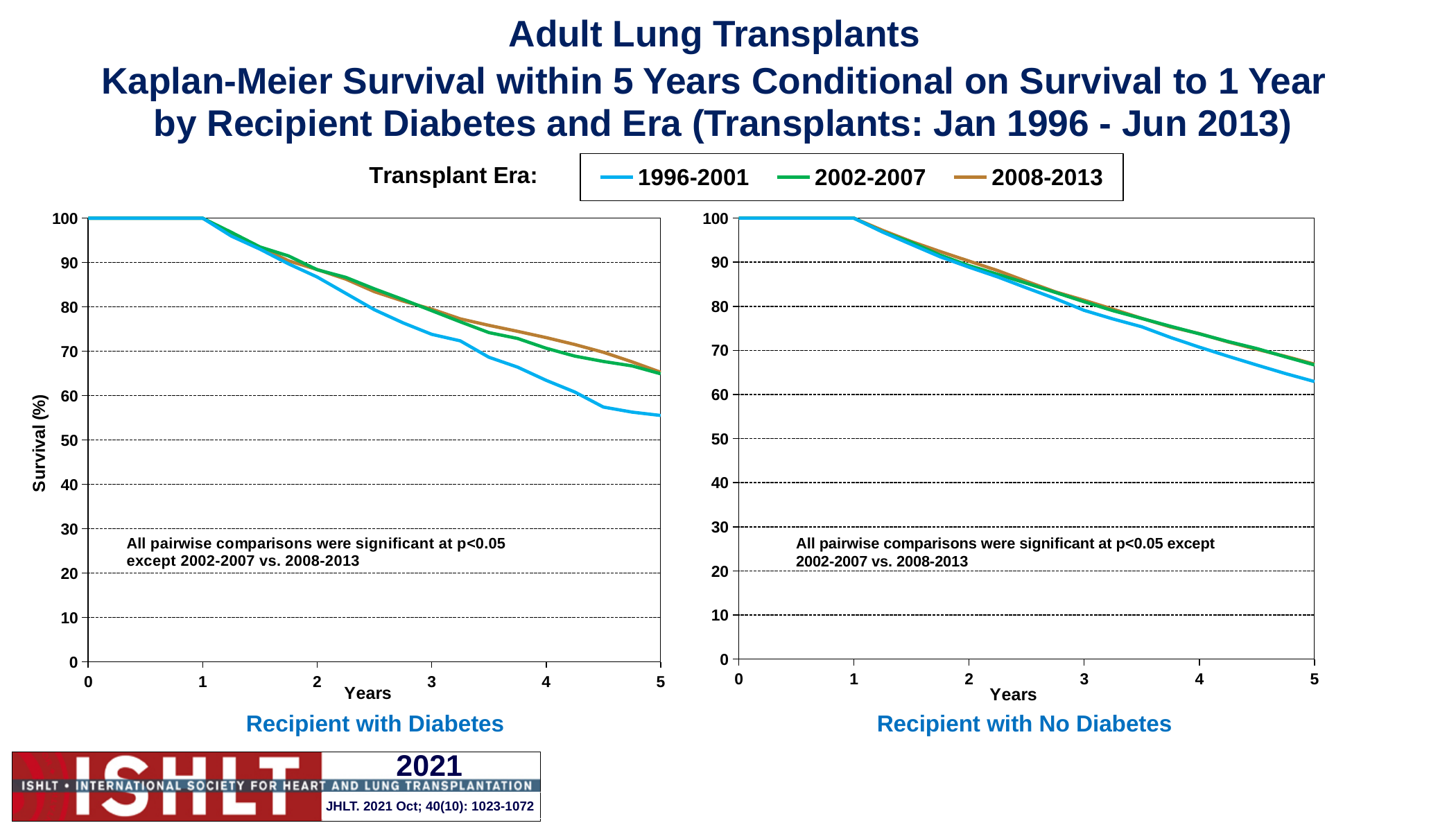
How many transplant eras does the legend list? 3 In the 'Recipient with Diabetes' chart, is the survival for 1996-2001 at year 3 greater or less than 70? greater In the 'Recipient with No Diabetes' chart, which era has higher survival at year 5: 1996-2001 or 2002-2007? 2002-2007 In the 'Recipient with Diabetes' chart, is the survival for 2008-2013 at year 4 greater or less than 70? greater What kind of chart is the 'Recipient with Diabetes' chart? line chart In the 'Recipient with Diabetes' chart, is the survival for 2002-2007 at year 5 greater or less than 60? greater In the 'Recipient with Diabetes' chart, which era has higher survival at year 5: 1996-2001 or 2002-2007? 2002-2007 In the 'Recipient with No Diabetes' chart, do the survival curves rise or fall from year 1 to year 5? fall Which transplant era is drawn in green in the legend? 2002-2007